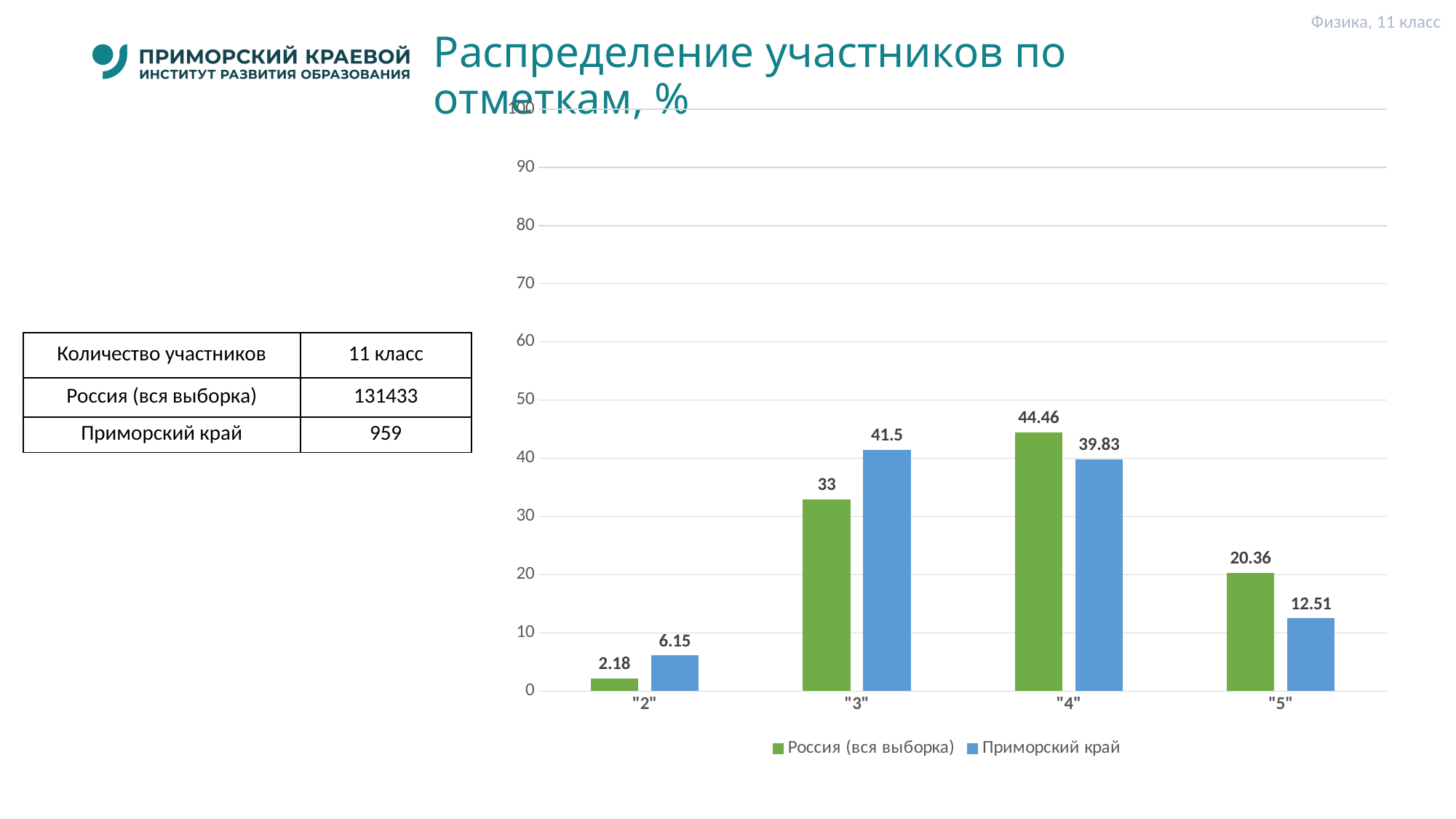
How many series does the legend list? 2 Which grade has the lowest value for Россия (вся выборка)? "2" What is the value for Приморский край for grade "2"? 6.15 Is the value for Россия (вся выборка) for grade "5" greater or less than 30? less What is the value for Россия (вся выборка) for grade "4"? 44.46 Which grade has the highest value for Приморский край? "3" How many grade categories are shown on the x axis? 4 What is the difference between Россия (вся выборка) and Приморский край for grade "5"? 7.85 What colour are the bars for Приморский край? Blue For grade "3", which series has the larger value: Россия (вся выборка) or Приморский край? Приморский край What is the value for Приморский край for grade "3"? 41.5 What type of chart is shown on the slide? Bar chart